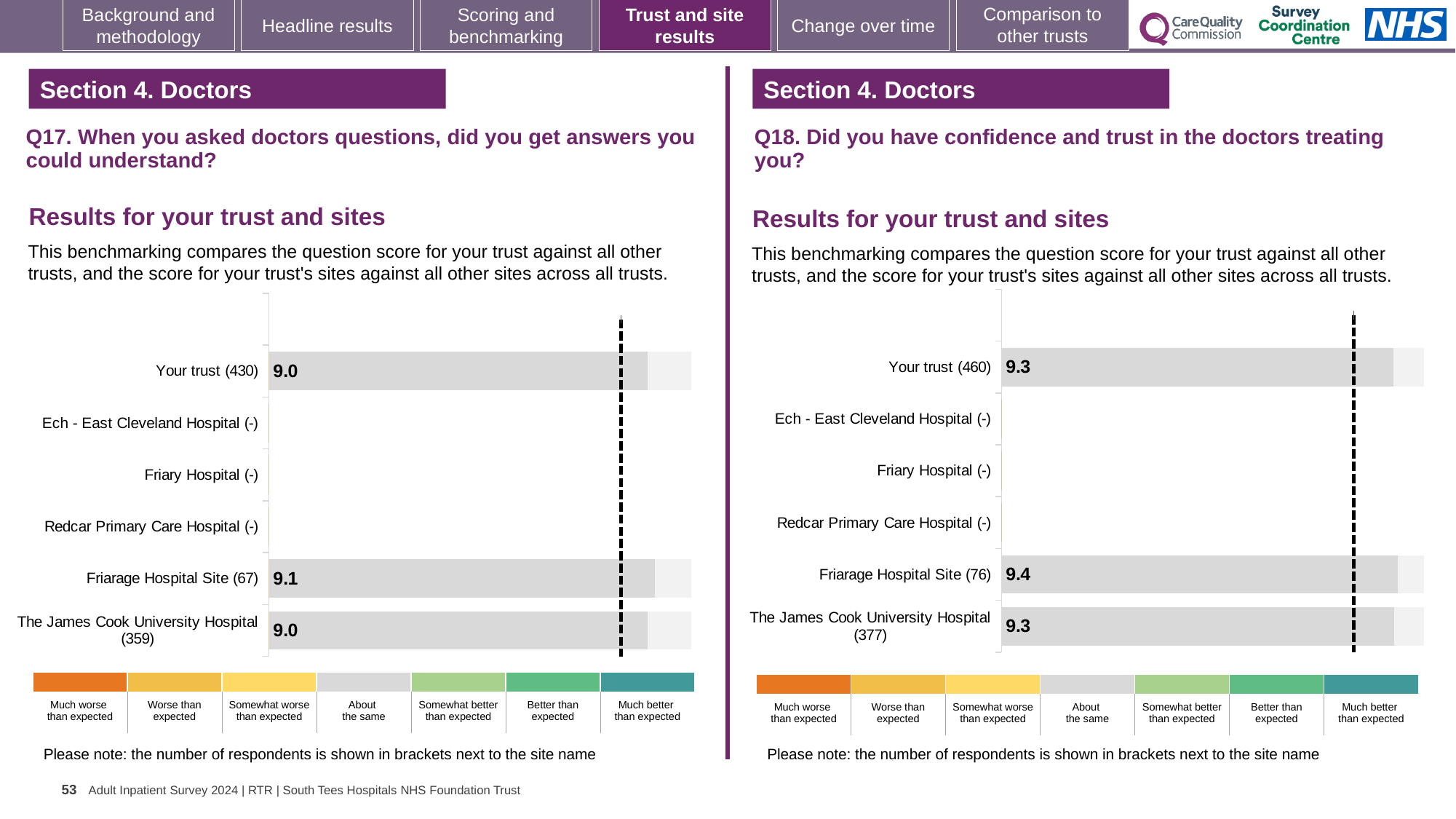
On the Q17 chart (left), what is the score for Friarage Hospital Site (67)? 9.1 On the Q18 chart (right), what is the difference between the Friarage Hospital Site score and The James Cook University Hospital score? 0.1 On the Q17 chart (left), how many respondents are shown in brackets for The James Cook University Hospital? 359 On the Q17 chart (left), what is the score for The James Cook University Hospital (359)? 9.0 What type of chart is used on the Q18 chart (right)? Bar chart On the Q17 chart (left), what is the score for Your trust (430)? 9.0 On the Q17 chart (left), what is the difference between the Friarage Hospital Site score and the Your trust score? 0.1 On the Q18 chart (right), what is the score for Your trust (460)? 9.3 How many site/trust categories are listed on the Q17 chart (left)? 6 On the Q18 chart (right), what is the score for Friarage Hospital Site (76)? 9.4 On the Q18 chart (right), what is the score for The James Cook University Hospital (377)? 9.3 On the Q18 chart (right), which site has the highest score? Friarage Hospital Site (76)